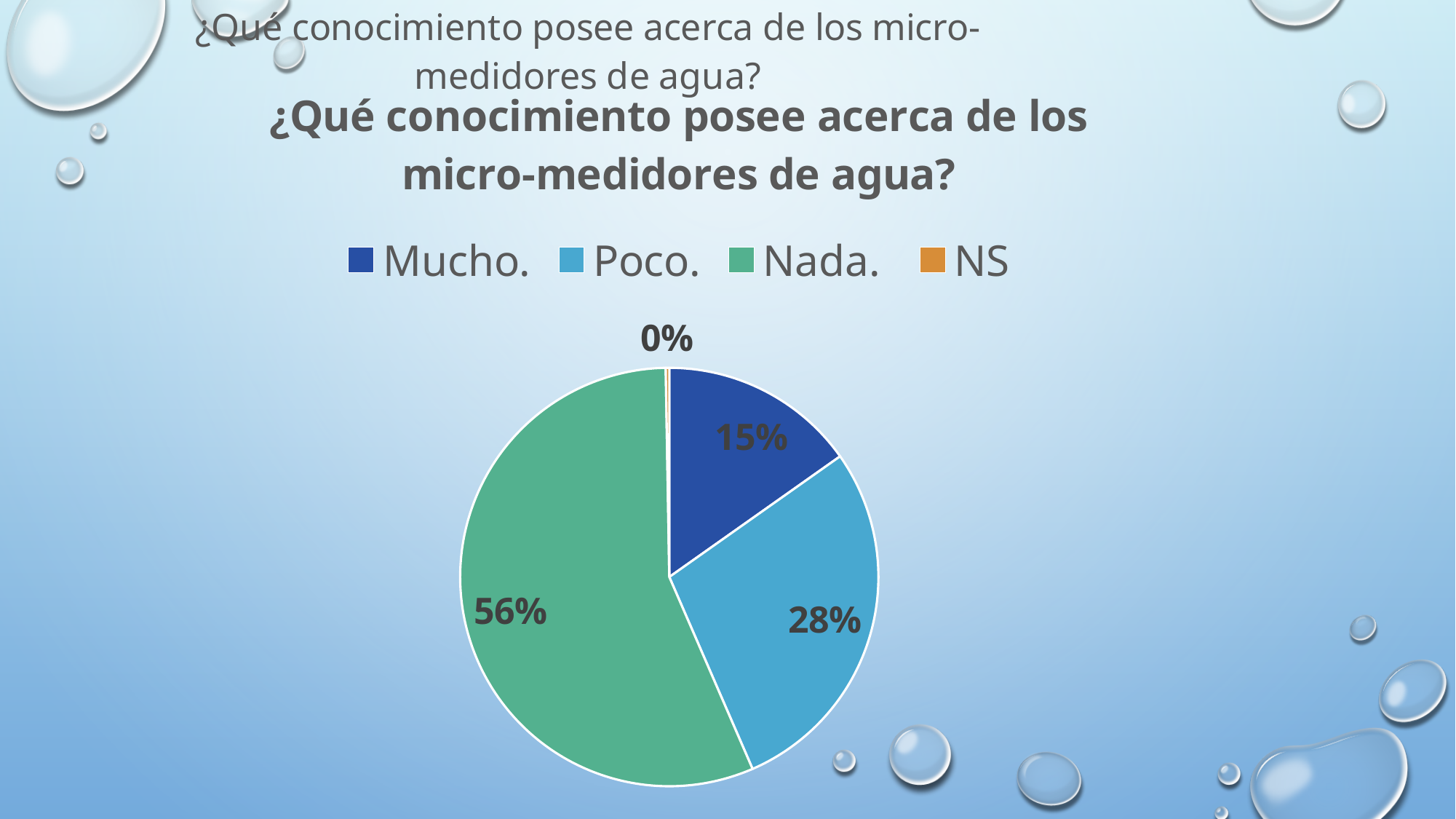
How many categories does the legend list? 4 What kind of chart is shown on the slide? pie chart What is the difference between the shares for "Poco." and "Mucho."? 13% What share of the pie does "Mucho." represent? 15% What colour is the slice for "Nada."? green What share of the pie does "Nada." represent? 56% What share of the pie does "Poco." represent? 28% What is the difference between the shares for "Nada." and "Poco."? 28% Which category has the smallest slice of the pie? NS Which category has the largest slice of the pie? Nada. Which is larger, the share for "Mucho." or the share for "Poco."? Poco.